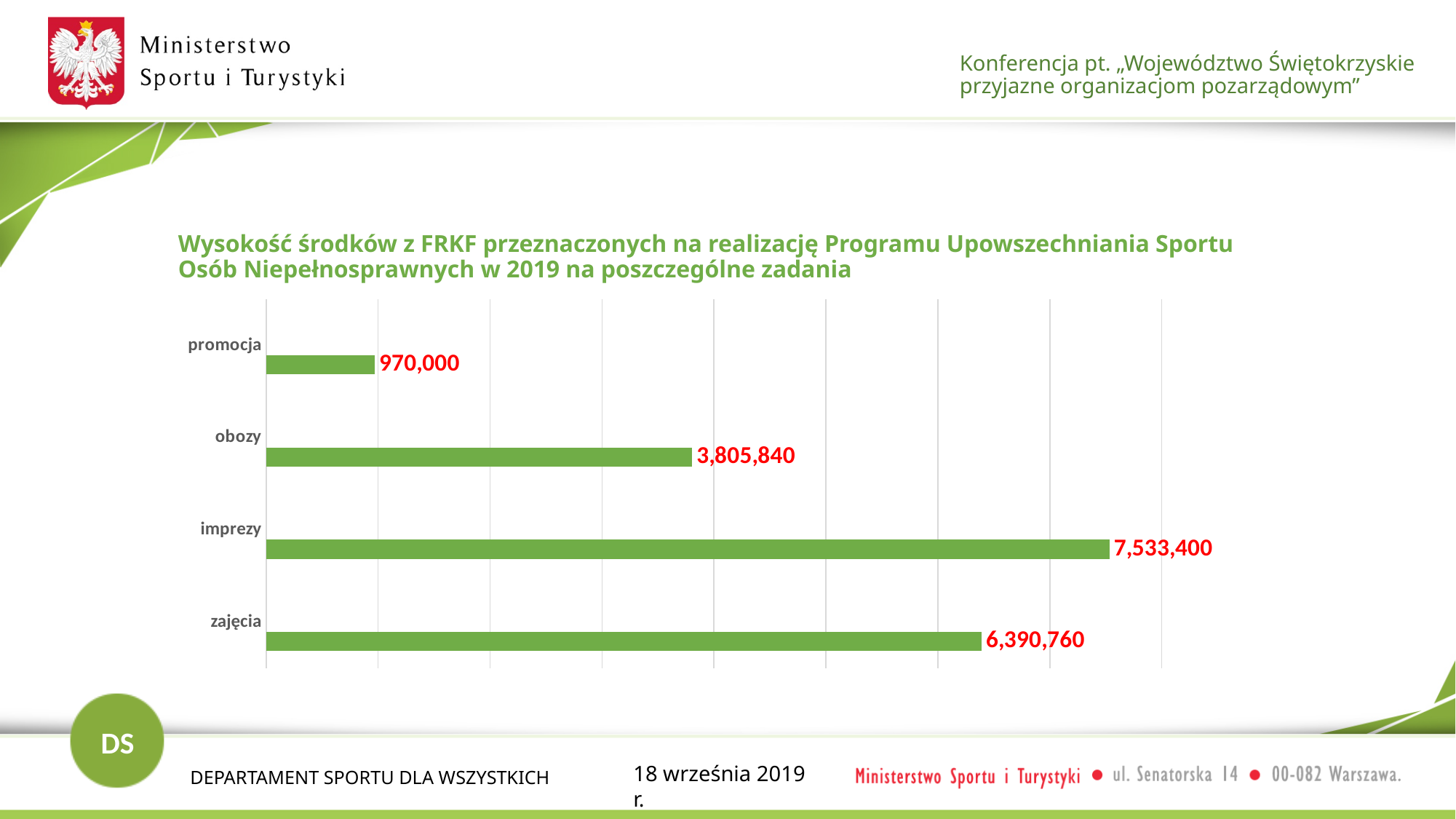
What is the value for obozy? 3,805,840 What kind of chart is shown on the slide? bar chart Which category has the highest value? imprezy What colour are the bars in the chart? green How many categories are shown in the chart? 4 Which is larger, the value for obozy or the value for zajęcia? zajęcia What is the value for zajęcia? 6,390,760 What is the value for imprezy? 7,533,400 What is the difference between the values for imprezy and zajęcia? 1,142,640 Which category has the lowest value? promocja What is the value for promocja? 970,000 What is the difference between the values for obozy and promocja? 2,835,840